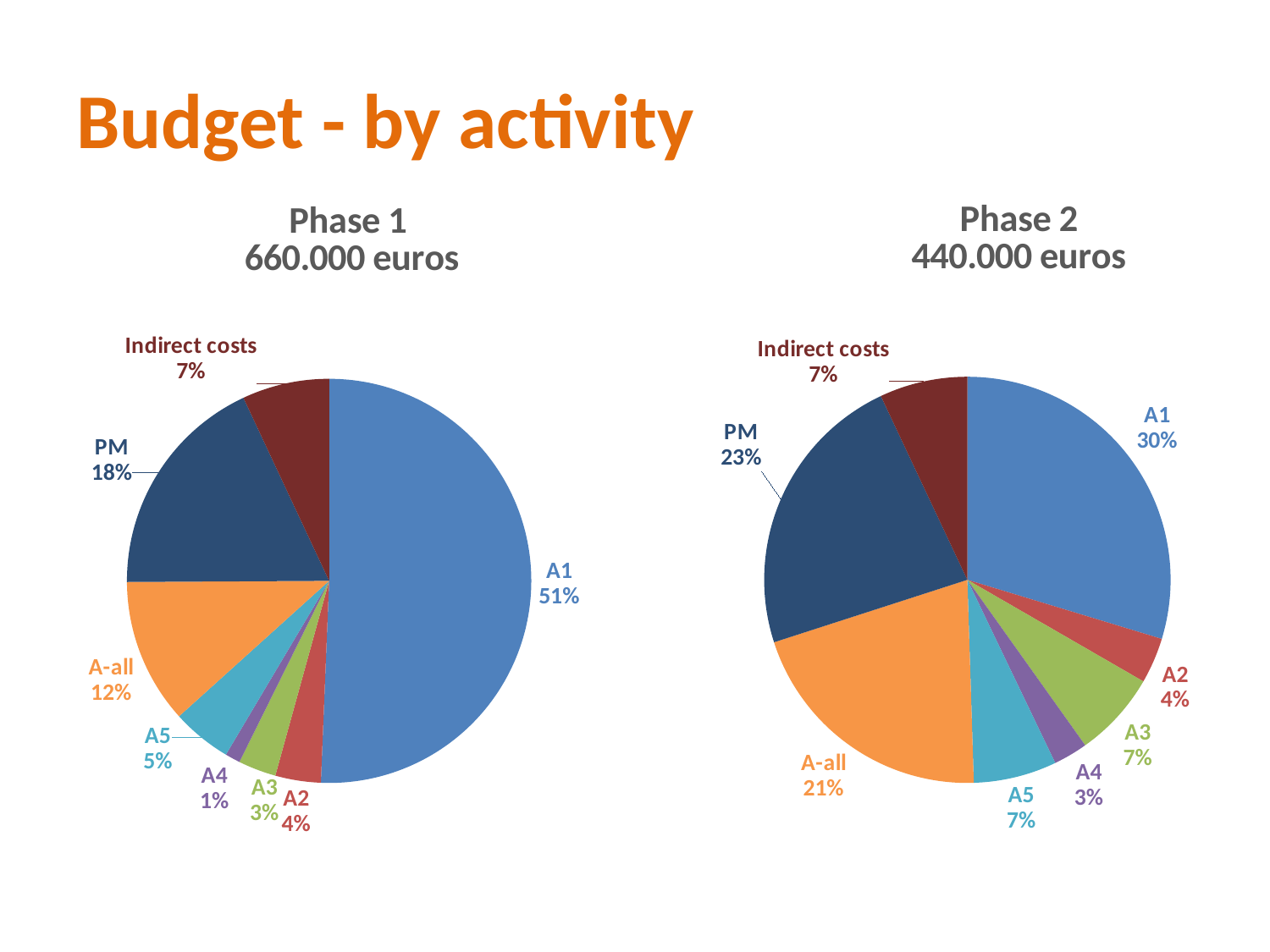
In the Phase 2 pie chart, what share does PM have? 23% In the Phase 2 pie chart, what is the difference between the shares of A1 and A-all? 9% In the Phase 1 pie chart, which is larger, the share of PM or the share of A-all? PM What kind of chart is used for Phase 1? Pie chart What total budget is shown in the title of the Phase 2 chart? 440.000 euros How many slices does the Phase 2 pie chart have? 8 In the Phase 1 pie chart, which category has the smallest share? A4 In the Phase 1 pie chart, what share does A1 have? 51% In the Phase 2 pie chart, what share does A5 have? 7% In the Phase 2 pie chart, which category has the smallest share? A4 In the Phase 1 pie chart, which category has the largest share? A1 In the Phase 1 pie chart, what is the difference between the shares of A1 and PM? 33%